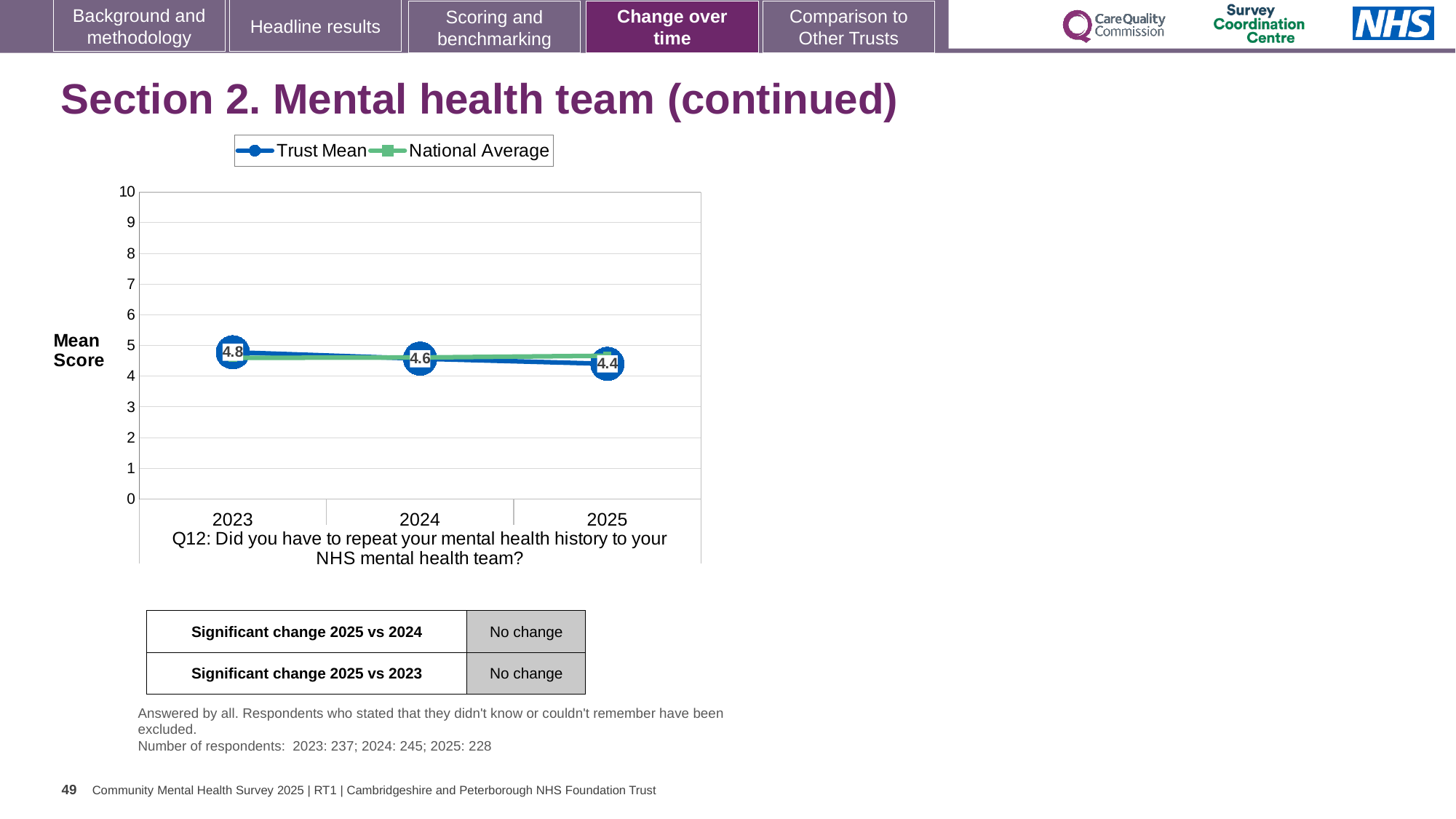
Does the Trust Mean score rise or fall from 2023 to 2025? fall In which year is the Trust Mean score lowest? 2025 What is the Trust Mean score for 2025? 4.4 How many years are shown on the x axis? 3 What is the Trust Mean score for 2023? 4.8 In which year is the Trust Mean score highest? 2023 What is the Trust Mean score for 2024? 4.6 What is the difference between the Trust Mean score in 2023 and in 2025? 0.4 How many series does the legend list? 2 Which is larger, the Trust Mean score in 2023 or in 2025? 2023 Is the National Average value for 2023 greater or less than 5? less What kind of chart is shown on the slide? line chart